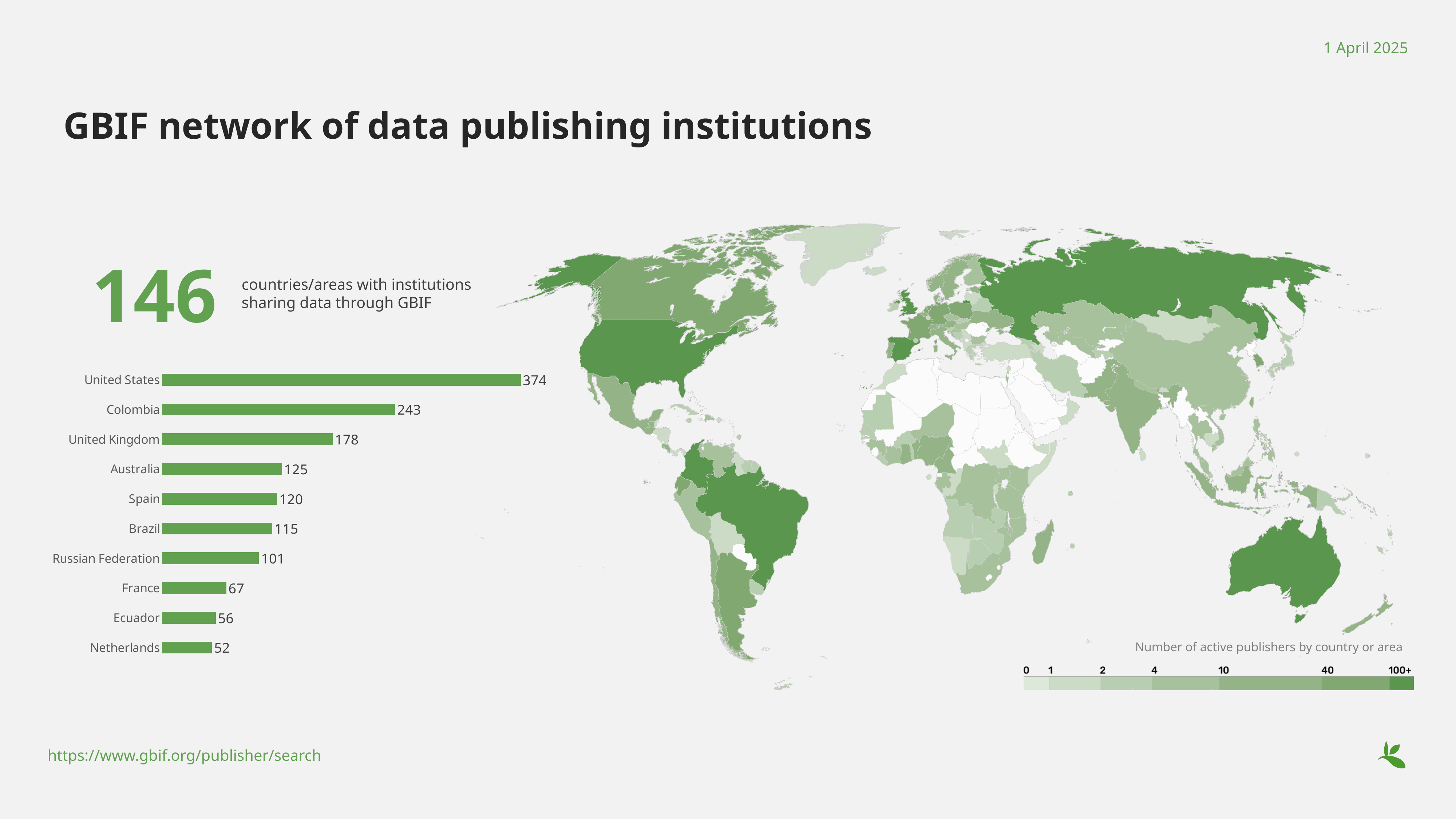
In the bar chart, which is larger, the value for the United Kingdom or the value for Brazil? United Kingdom In the bar chart, what is the value for Colombia? 243 In the bar chart, how many active publishers does the United States have? 374 In the bar chart, what is the value for France? 67 What kind of chart is shown on the left of the slide? Bar chart How many countries are shown in the bar chart? 10 In the bar chart, which country has the lowest value? Netherlands In the bar chart, what is the difference between the values for Australia and Spain? 5 In the bar chart, which country has the highest value? United States What is the highest value shown on the map's colour legend? 100+ In the bar chart, what is the value for the Russian Federation? 101 In the bar chart, what is the difference between the values for the United States and Colombia? 131